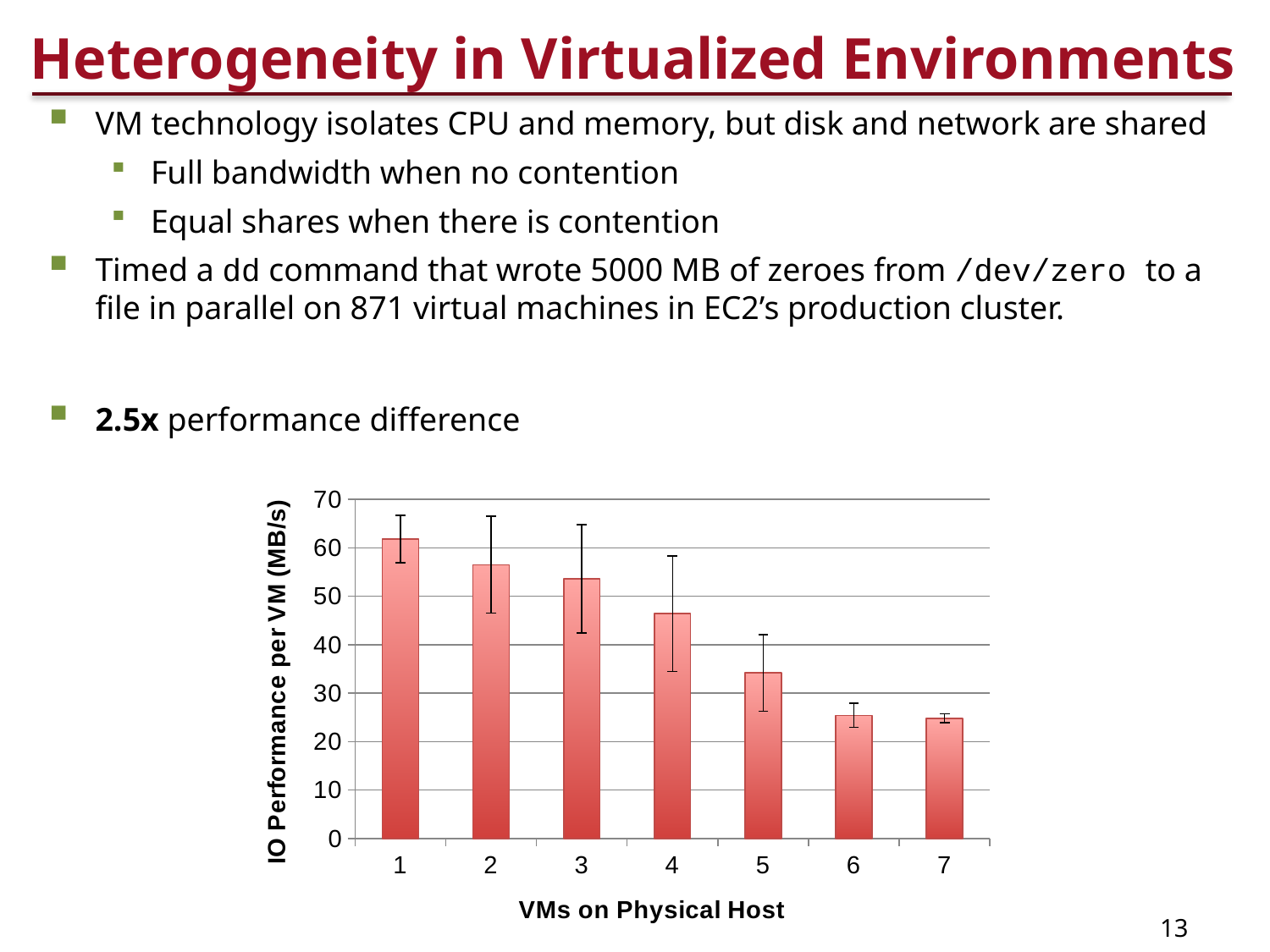
What is the label of the y axis? IO Performance per VM (MB/s) Do the IO performance values rise or fall as the number of VMs on the physical host increases? fall What kind of chart is shown on the slide? bar chart How many categories (numbers of VMs on a physical host) are plotted on the x axis? 7 Is the IO performance per VM for 4 VMs on a physical host greater or less than 50? less Is the IO performance per VM for 5 VMs on a physical host greater or less than 30? greater Is the IO performance per VM for 2 VMs on a physical host greater or less than 50? greater What is the label of the x axis? VMs on Physical Host Which has the higher IO performance per VM: 1 VM or 5 VMs on a physical host? 1 Which number of VMs on a physical host has the highest IO performance per VM? 1